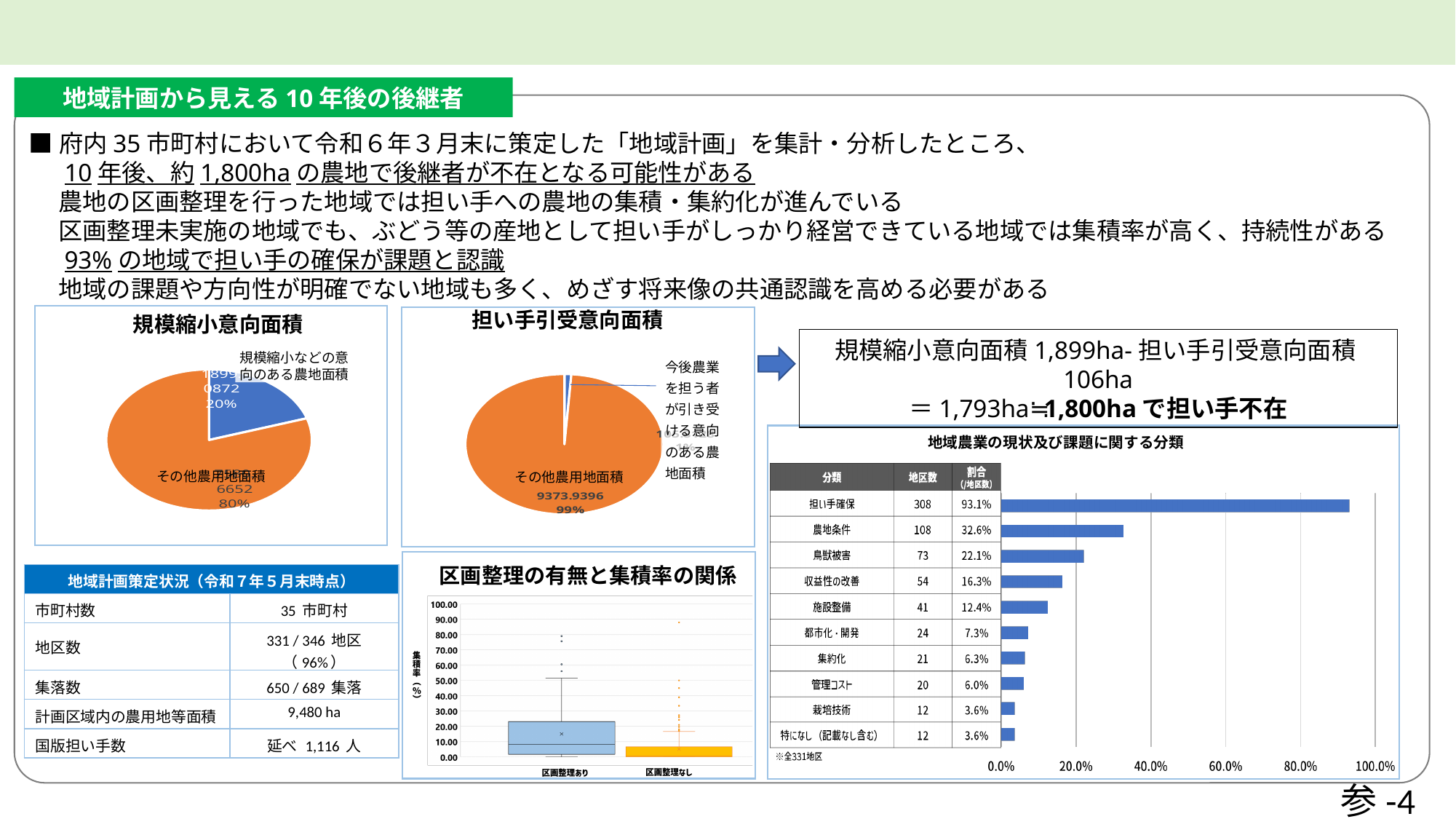
In the chart titled 地域農業の現状及び課題に関する分類, what is the difference in 割合 between 担い手確保 and 農地条件? 60.5% In the pie chart titled 担い手引受意向面積, what value is printed for その他農用地面積? 9373.9396 In the chart titled 区画整理の有無と集積率の関係, how many categories are shown on the x axis? 2 In the pie chart titled 規模縮小意向面積, what percentage share does その他農用地面積 have? 80% In the pie chart titled 担い手引受意向面積, what percentage share does その他農用地面積 have? 99% In the chart titled 地域農業の現状及び課題に関する分類, which has a larger 割合, 施設整備 or 都市化・開発? 施設整備 In the chart titled 地域農業の現状及び課題に関する分類, how many categories are shown? 10 What kind of chart is the chart titled 地域農業の現状及び課題に関する分類? Bar chart In the pie chart titled 規模縮小意向面積, what percentage share does 規模縮小などの意向のある農地面積 have? 20% In the chart titled 地域農業の現状及び課題に関する分類, which category has the highest 割合? 担い手確保 In the chart titled 地域農業の現状及び課題に関する分類, what is the 割合 for 鳥獣被害? 22.1% What kind of chart is the chart titled 規模縮小意向面積? Pie chart